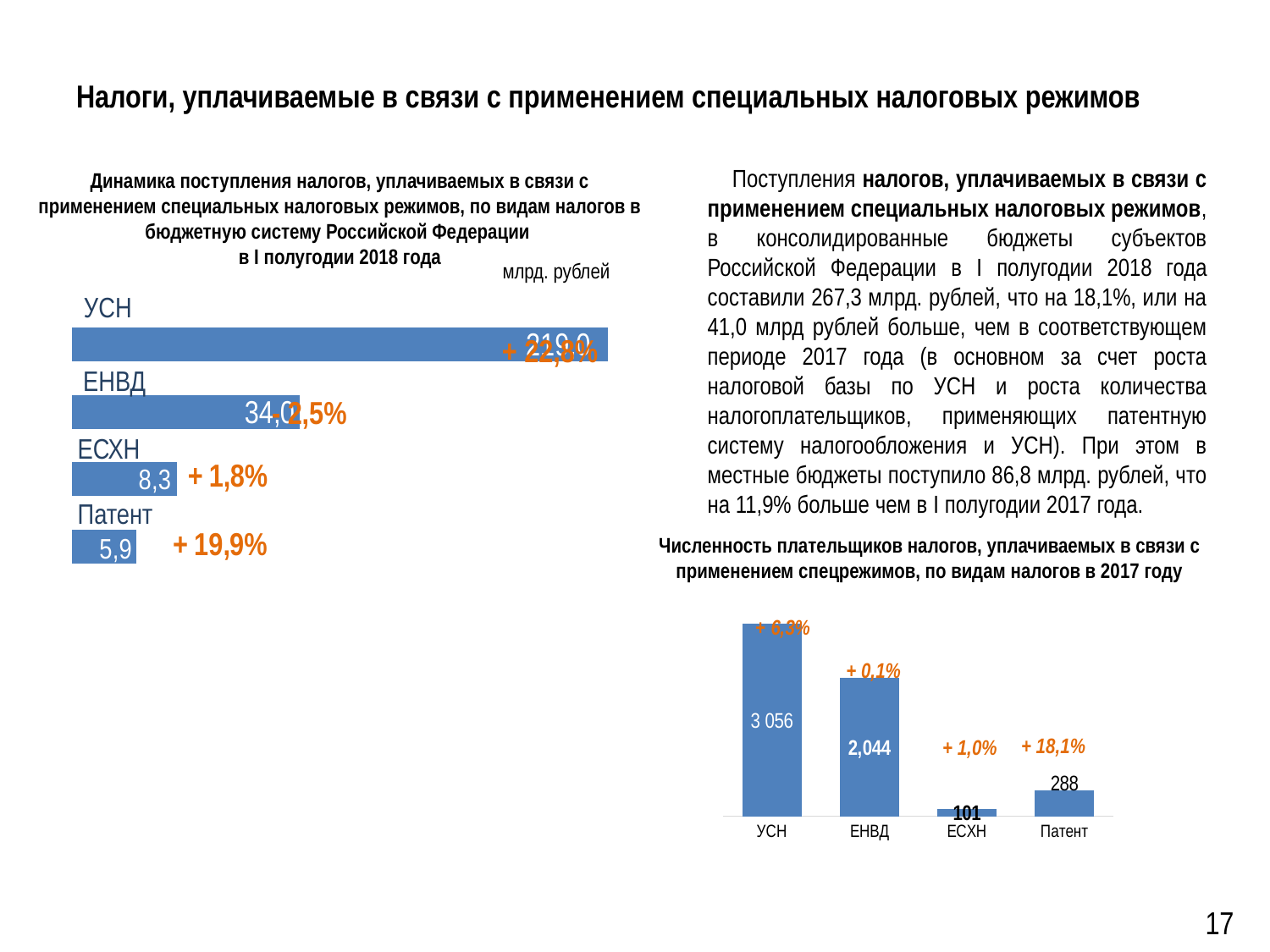
How many categories are shown in the left chart (Динамика поступления налогов)? 4 What kind of chart is the left chart titled «Динамика поступления налогов, уплачиваемых в связи с применением специальных налоговых режимов»? bar chart In the right chart (Численность плательщиков налогов), which category has the lowest value? ЕСХН In the left chart (Динамика поступления налогов), which category has the highest value? УСН In the right chart (Численность плательщиков налогов), what is the value for УСН? 3 056 In the left chart (Динамика поступления налогов), what is the difference between the values for ЕСХН and Патент? 2,4 In the left chart (Динамика поступления налогов), what is the value for Патент? 5,9 In the left chart (Динамика поступления налогов), which category has the lowest value? Патент In the right chart (Численность плательщиков налогов), what is the difference between the values for Патент and ЕСХН? 187 What unit is indicated for the left chart (Динамика поступления налогов)? млрд. рублей In the left chart (Динамика поступления налогов), what is the value for ЕСХН? 8,3 In the right chart (Численность плательщиков налогов), what is the value for ЕНВД? 2,044